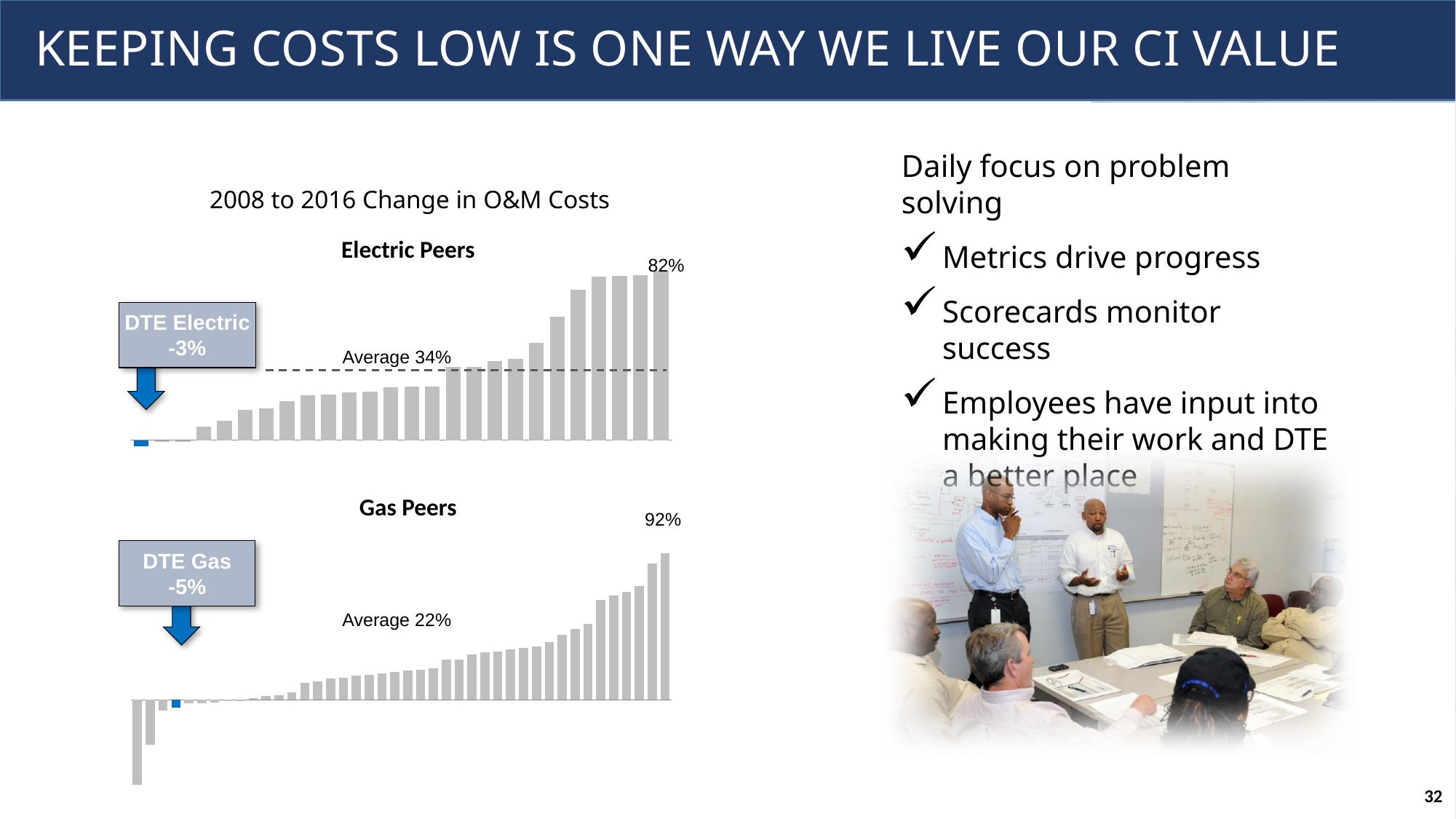
In the Electric Peers chart, is DTE Electric's value above or below the average? Below What kind of chart is the Gas Peers chart? Bar chart In the Electric Peers chart, what is the highest change in O&M costs shown? 82% In the Gas Peers chart, what is the difference in percentage points between the average and DTE Gas? 27 percentage points In the Electric Peers chart, what is the change in O&M costs for DTE Electric? -3% In the Gas Peers chart, what is the change in O&M costs for DTE Gas? -5% In the Electric Peers chart, what is the difference in percentage points between the highest peer value and DTE Electric? 85 percentage points In the Electric Peers chart, what is the average change in O&M costs? 34% In the Electric Peers chart, do the bar values rise or fall from left to right? Rise In the Gas Peers chart, what is the highest change in O&M costs shown? 92% In the Gas Peers chart, what is the average change in O&M costs? 22% Which is larger: the highest value in the Electric Peers chart or the highest value in the Gas Peers chart? Gas Peers (92%)